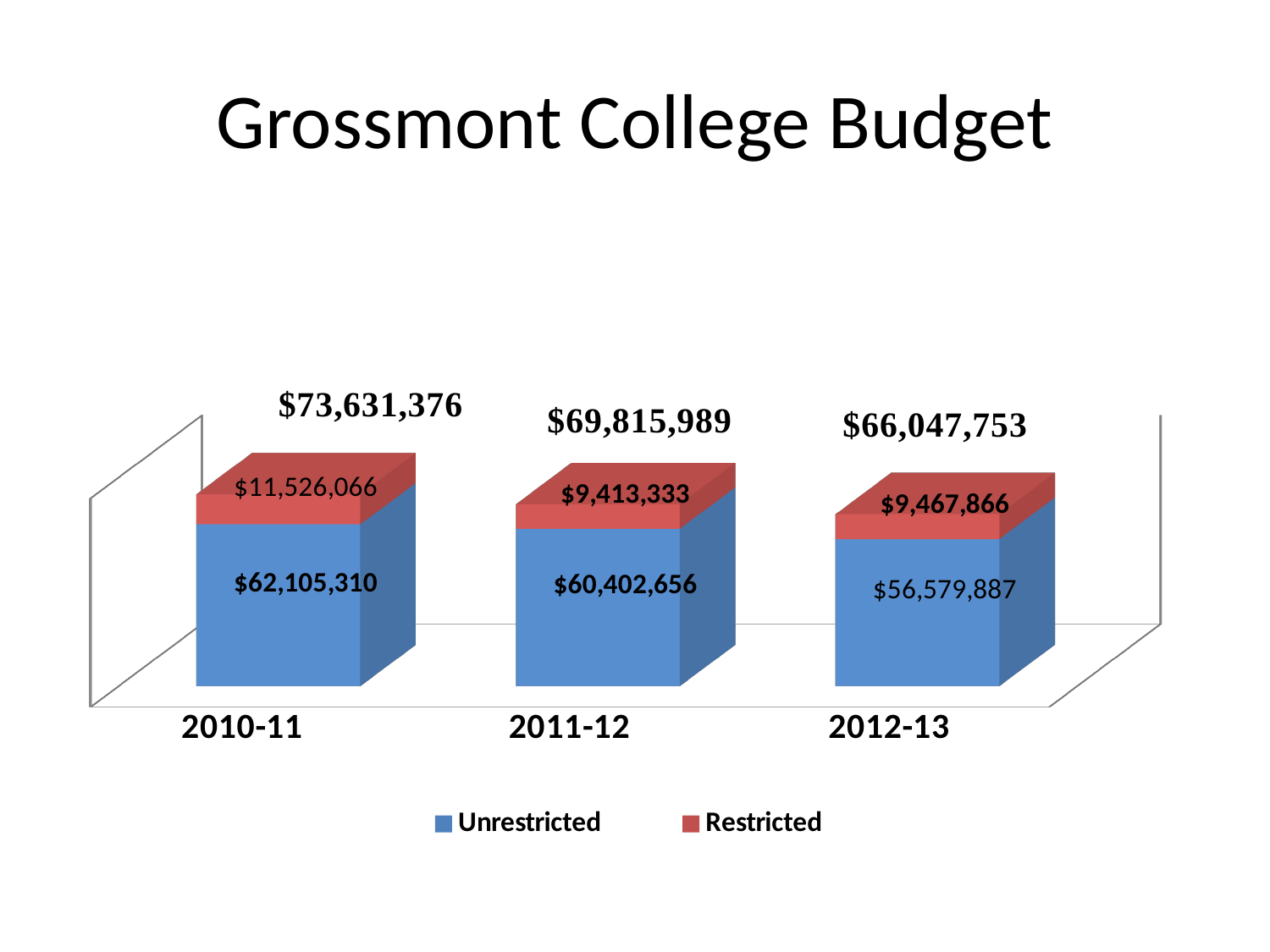
What is the Unrestricted value for 2010-11? $62,105,310 What is the difference between the Unrestricted values for 2010-11 and 2011-12? $1,702,654 Do the total budget values rise or fall from 2010-11 to 2012-13? fall Which year has the lowest Unrestricted value? 2012-13 Which year has the highest total budget? 2010-11 What is the total budget shown for 2011-12? $69,815,989 What is the Restricted value for 2011-12? $9,413,333 Which is larger, the Restricted value for 2011-12 or for 2012-13? 2012-13 What is the Unrestricted value for 2012-13? $56,579,887 How many series does the legend list? 2 What is the total budget shown for 2012-13? $66,047,753 What is the Restricted value for 2010-11? $11,526,066